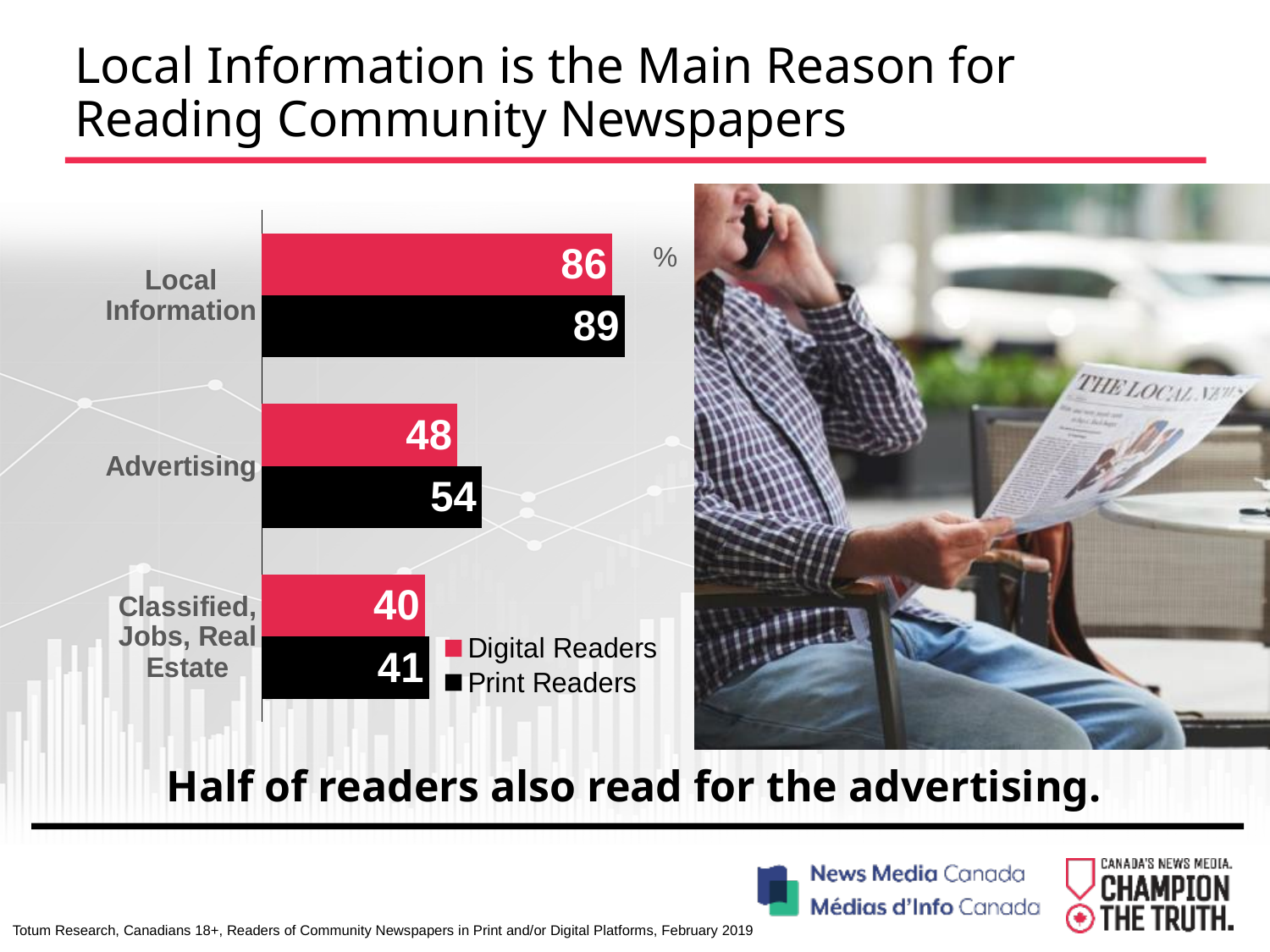
How many series does the legend list? 2 What is the value for Print Readers for Advertising? 54 What is the value for Digital Readers for Local Information? 86 How many categories are shown in the chart? 3 What kind of chart is shown on the slide? Bar chart Which colour represents Digital Readers in the chart? Red Which category has the lowest value for Digital Readers? Classified, Jobs, Real Estate What is the difference between Print Readers and Digital Readers for Advertising? 6 For Advertising, which is larger: Digital Readers or Print Readers? Print Readers What is the difference between Print Readers and Digital Readers for Local Information? 3 What is the value for Print Readers for Classified, Jobs, Real Estate? 41 Which category has the highest value for Print Readers? Local Information